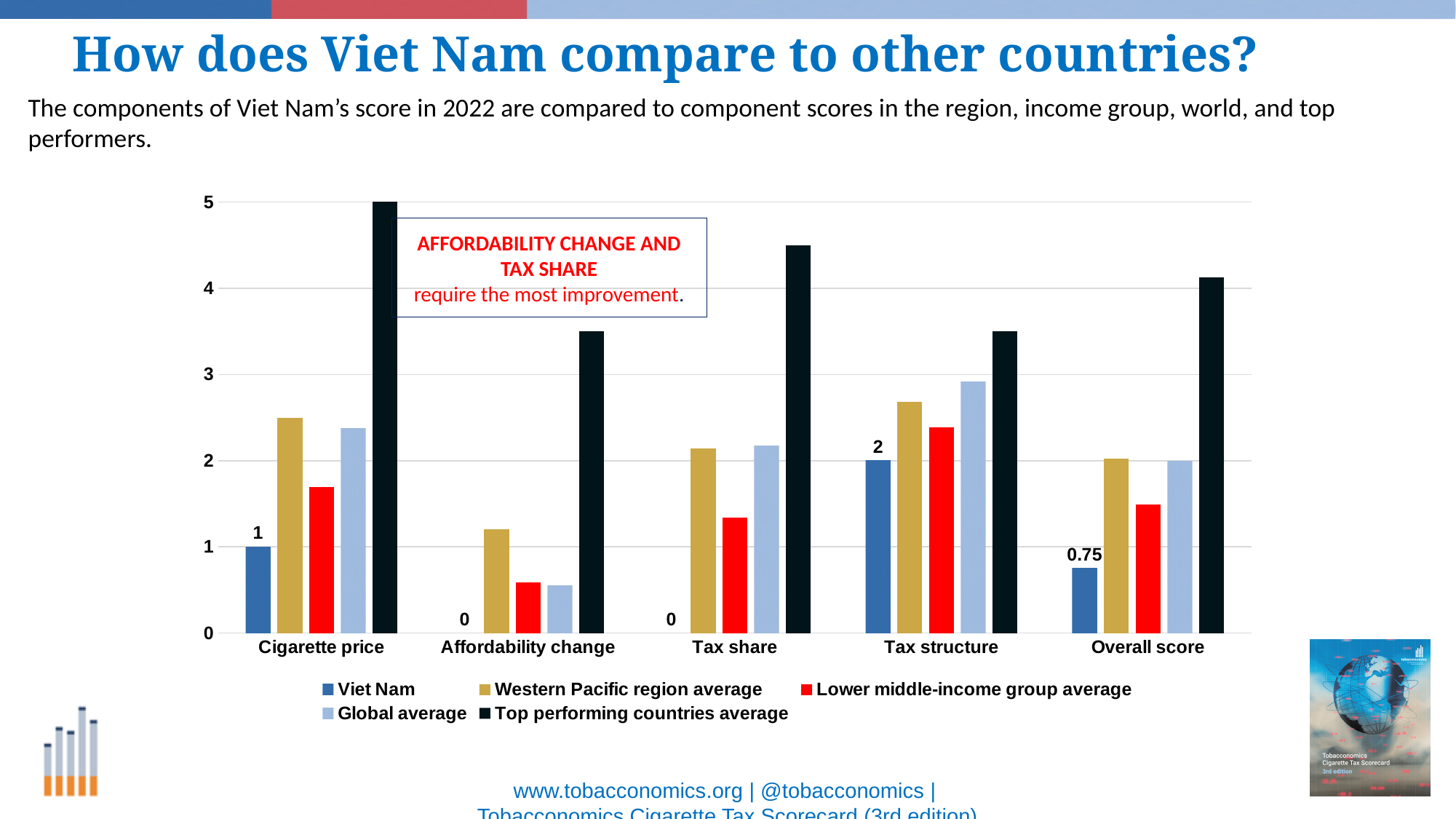
What is the value for Viet Nam in the Overall score category? 0.75 In which category does Viet Nam have its highest value? Tax structure How many series does the legend list? 5 How many categories are shown on the x axis of the chart? 5 Is the value for Top performing countries average in the Tax share category greater or less than 4? greater What is the value for Viet Nam in the Tax structure category? 2 Is the value for Lower middle-income group average in the Affordability change category greater or less than 1? less What kind of chart is shown on the slide? Bar chart What is the value for Viet Nam in the Cigarette price category? 1 What is the difference between Viet Nam's Tax structure value and its Cigarette price value? 1 Which is larger for Viet Nam: the Cigarette price value or the Overall score value? Cigarette price What is the value for Viet Nam in the Affordability change category? 0